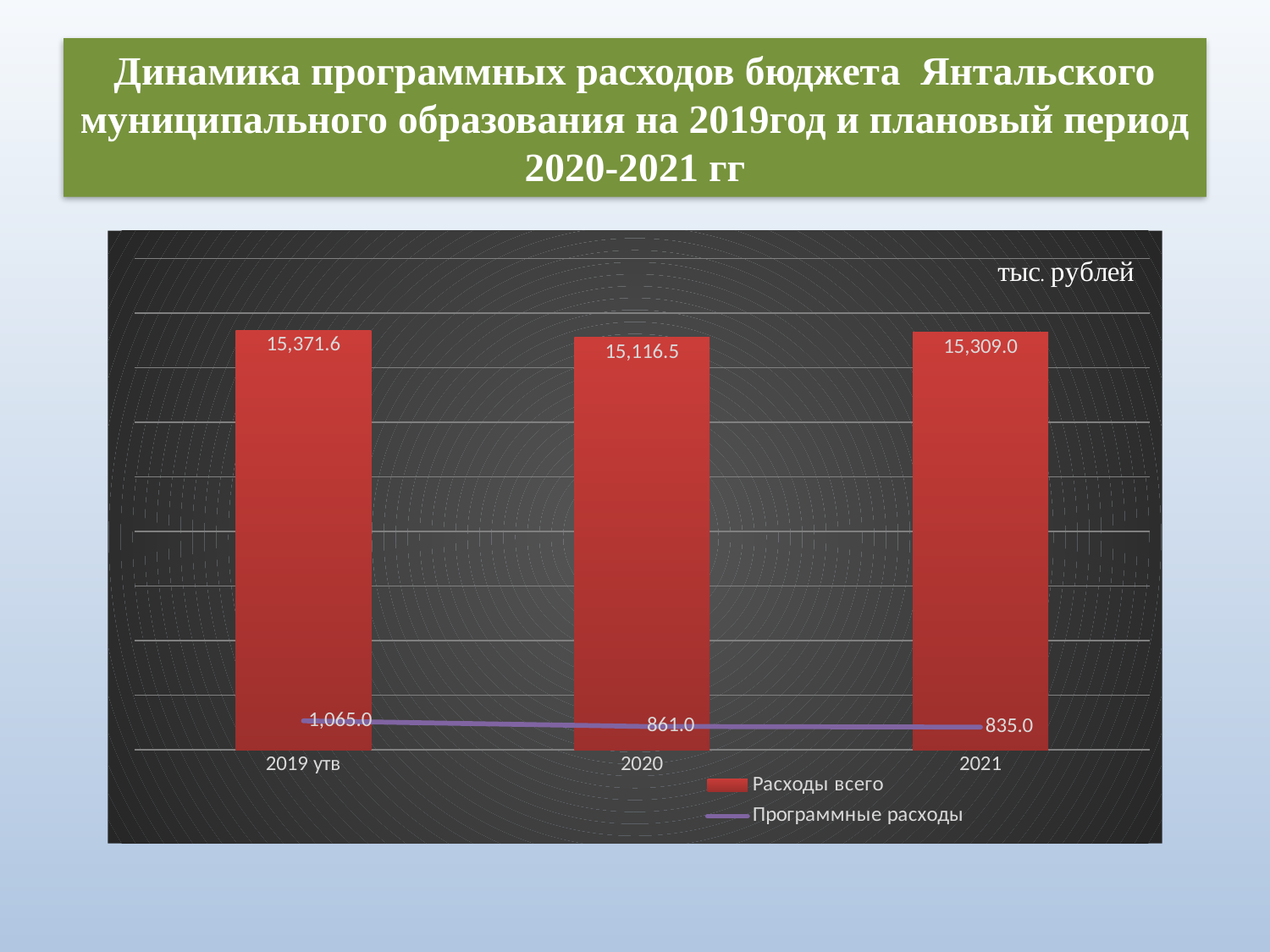
Which is larger: "Расходы всего" for 2021 or for 2020? 2021 How many series does the legend list? 2 What is the value of "Расходы всего" for 2020? 15,116.5 How many years are shown on the x axis? 3 Which year has the highest value of "Расходы всего"? 2019 утв What is the value of "Программные расходы" for 2021? 835.0 Which year has the lowest value of "Программные расходы"? 2021 What is the value of "Расходы всего" for 2019 утв? 15,371.6 What is the difference between "Расходы всего" for 2019 утв and 2020? 255.1 What is the value of "Программные расходы" for 2019 утв? 1,065.0 What is the difference between "Программные расходы" for 2019 утв and 2020? 204.0 Does the "Программные расходы" line rise or fall from 2019 утв to 2021? fall